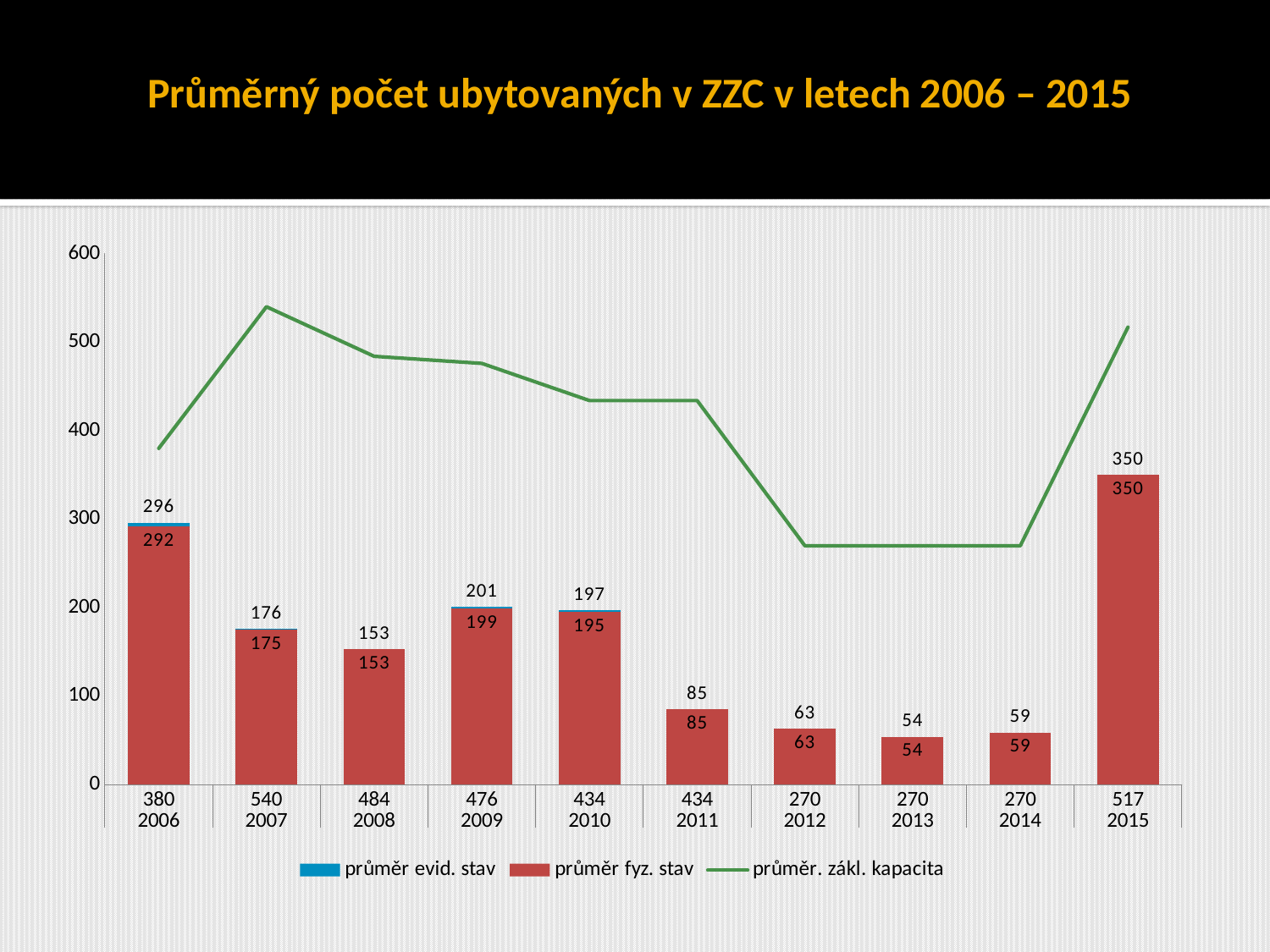
How many years are shown on the x axis? 10 Which year has the highest průměr fyz. stav? 2015 What is the difference between průměr evid. stav and průměr fyz. stav in 2006? 4 Which year has the larger průměr fyz. stav, 2009 or 2010? 2009 Does the průměr. zákl. kapacita line rise or fall from 2007 to 2014? Fall What is the title of the slide? Průměrný počet ubytovaných v ZZC v letech 2006 – 2015 What kind of chart is this? Combined bar and line chart What is the průměr. zákl. kapacita value shown for 2007? 540 Which year has the lowest průměr evid. stav? 2013 What is the value of průměr fyz. stav for 2015? 350 How many series does the legend list? 3 What is the value of průměr evid. stav for 2006? 296